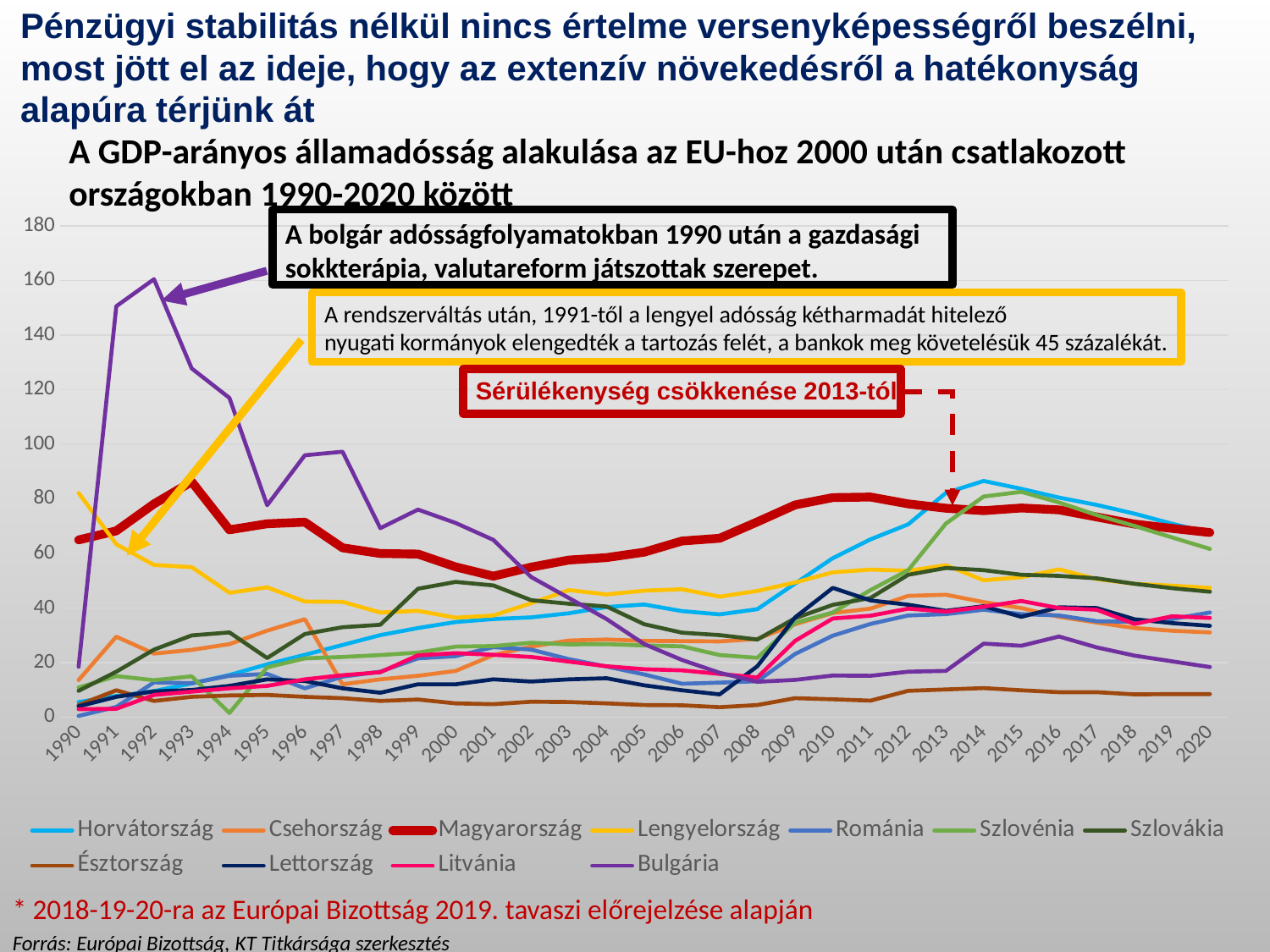
Is the value for Magyarország in 2010 greater or less than 60? greater What kind of chart is shown on the slide? line chart Which country's line is drawn as the thick red line in the chart? Magyarország Does the value for Bulgária rise or fall from 1992 to 2020? fall Which country has the highest debt-to-GDP value in 1992? Bulgária Which country has the lowest debt-to-GDP value in 2020? Észtország Is the value for Észtország in 2020 greater or less than 20? less Is the value for Lengyelország in 1990 greater or less than 60? greater How many countries (series) does the legend list? 11 How many years are shown along the x axis? 31 In 2020, which is larger: the value for Magyarország or the value for Észtország? Magyarország